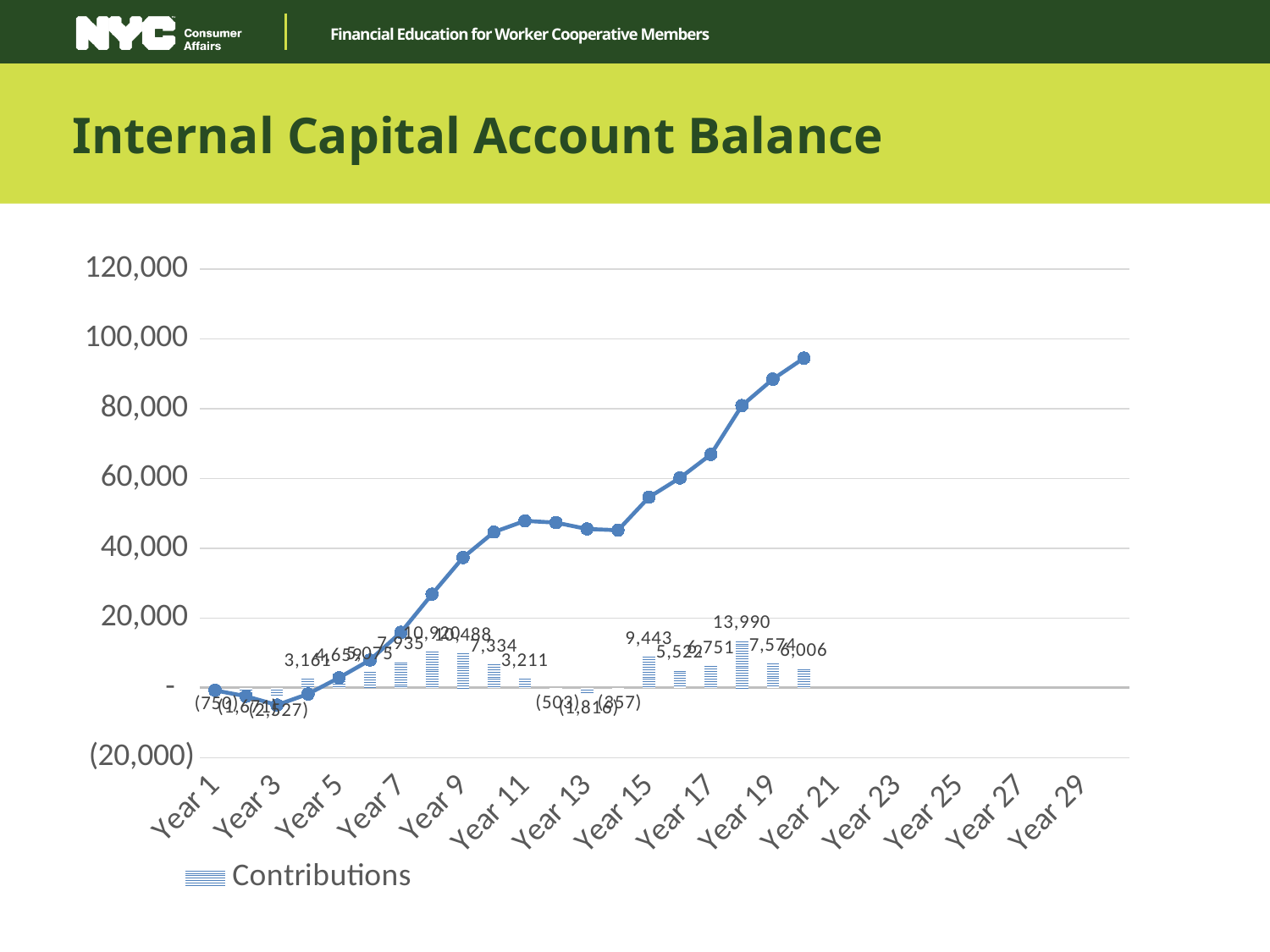
How many series does the legend list? 1 Is the value of the line series at Year 11 greater or less than 60,000? less Is the value of the line series at Year 20 greater or less than 80,000? greater What is the title of the slide containing the chart? Internal Capital Account Balance What is the highest Contributions data label shown on the chart? 13,990 How many year labels are shown along the x axis? 15 What series does the legend list? Contributions Does the line series generally rise or fall from Year 1 to Year 20? rise What is the highest value shown on the vertical axis? 120,000 Which is larger, the Contributions label 13,990 or the Contributions label 9,443? 13,990 Is the value of the line series at Year 7 greater or less than 20,000? less